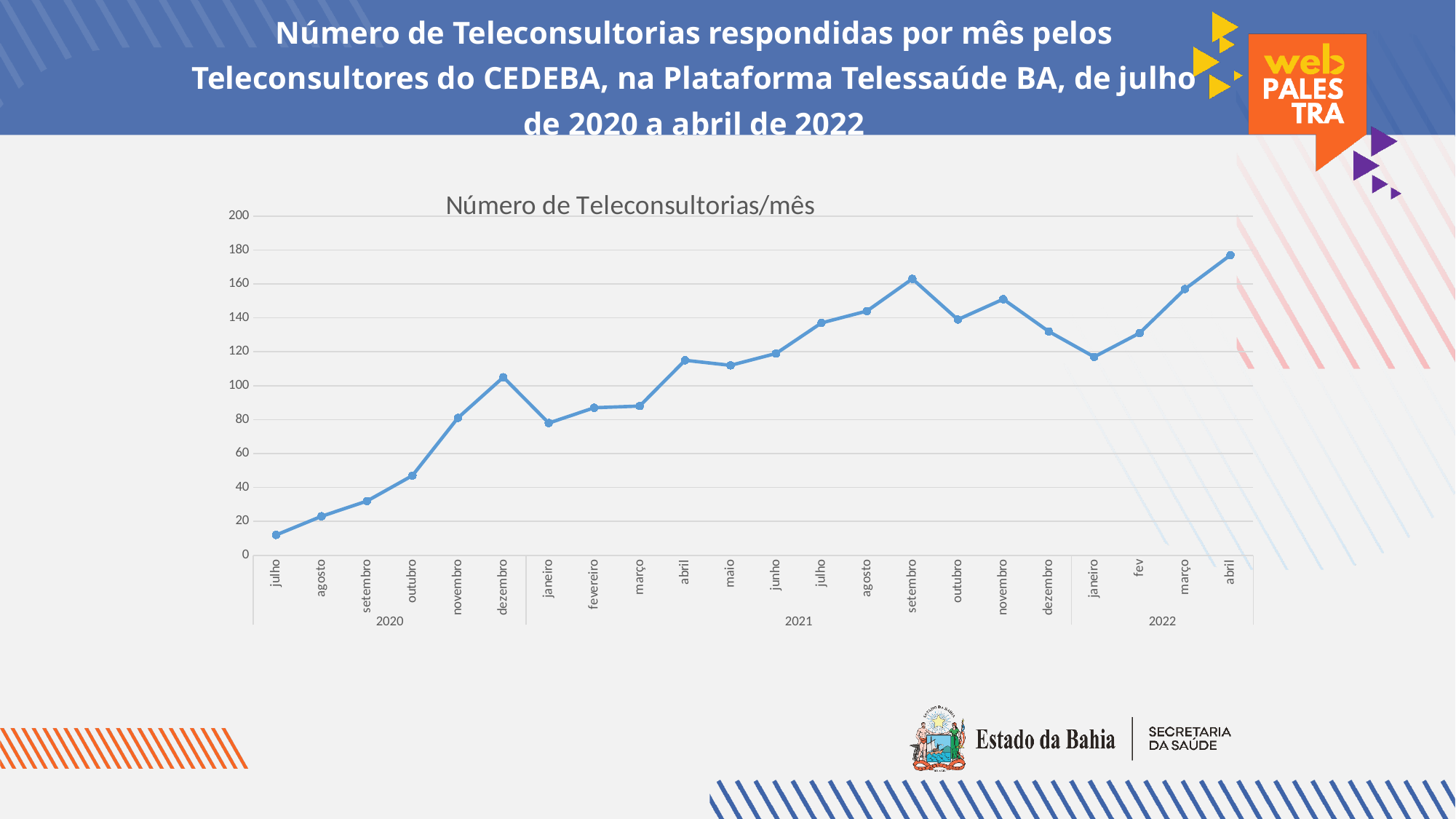
What kind of chart is shown on the slide? line chart What is the title printed above the chart? Número de Teleconsultorias/mês Which is larger, the value for setembro 2021 or the value for outubro 2021? setembro 2021 Is the value for março 2022 greater or less than 140? greater Which month has the highest number of teleconsultorias? abril 2022 How many monthly data points are plotted on the chart? 22 Which is larger, the value for dezembro 2020 or the value for janeiro 2021? dezembro 2020 Is the value for outubro 2020 greater or less than 60? less Is the value for setembro 2021 greater or less than 140? greater Overall, do the values rise or fall from julho 2020 to abril 2022? rise Which month has the lowest number of teleconsultorias? julho 2020